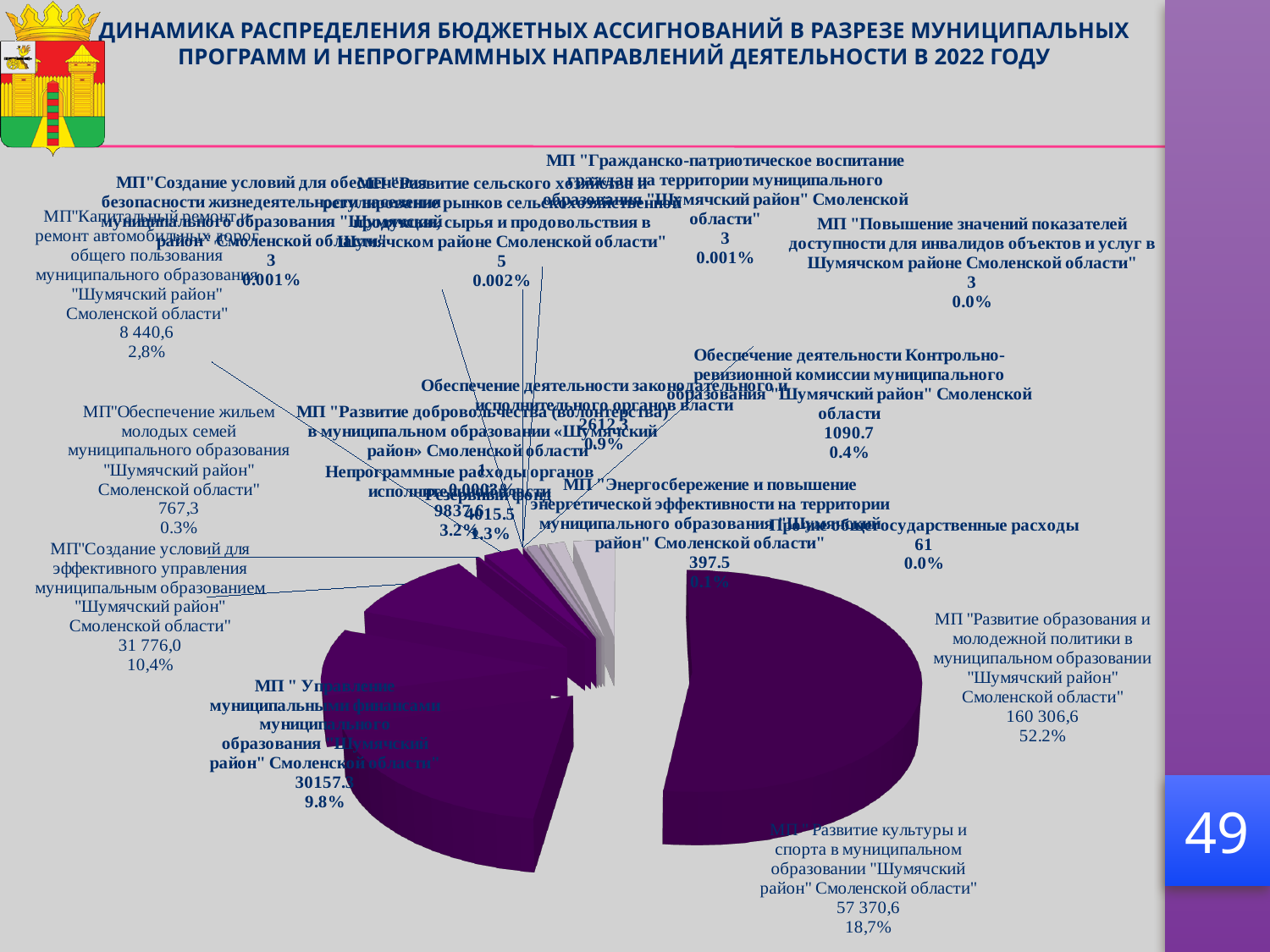
What percentage is shown for МП "Управление муниципальными финансами"? 9.8% What value is shown for МП "Капитальный ремонт и ремонт автомобильных дорог общего пользования"? 8 440,6 Which is larger: the share for МП "Развитие образования и молодежной политики" or for МП "Развитие культуры и спорта"? МП "Развитие образования и молодежной политики" What type of chart is shown on the slide? pie chart What value is shown for Обеспечение деятельности Контрольно-ревизионной комиссии? 1090.7 What value is shown for МП "Создание условий для эффективного управления муниципальным образованием"? 31 776,0 What share of the pie does МП "Развитие культуры и спорта" hold? 18,7% What is the difference in percentage points between the share of МП "Развитие образования и молодежной политики" (52.2%) and МП "Развитие культуры и спорта" (18,7%)? 33.5 What value is shown for МП "Развитие культуры и спорта в муниципальном образовании "Шумячский район" Смоленской области"? 57 370,6 Which category has the largest share of the pie? МП "Развитие образования и молодежной политики в муниципальном образовании "Шумячский район" Смоленской области" What value is shown for МП "Обеспечение жильем молодых семей"? 767,3 What share of the pie does МП "Развитие образования и молодежной политики" hold? 52.2%